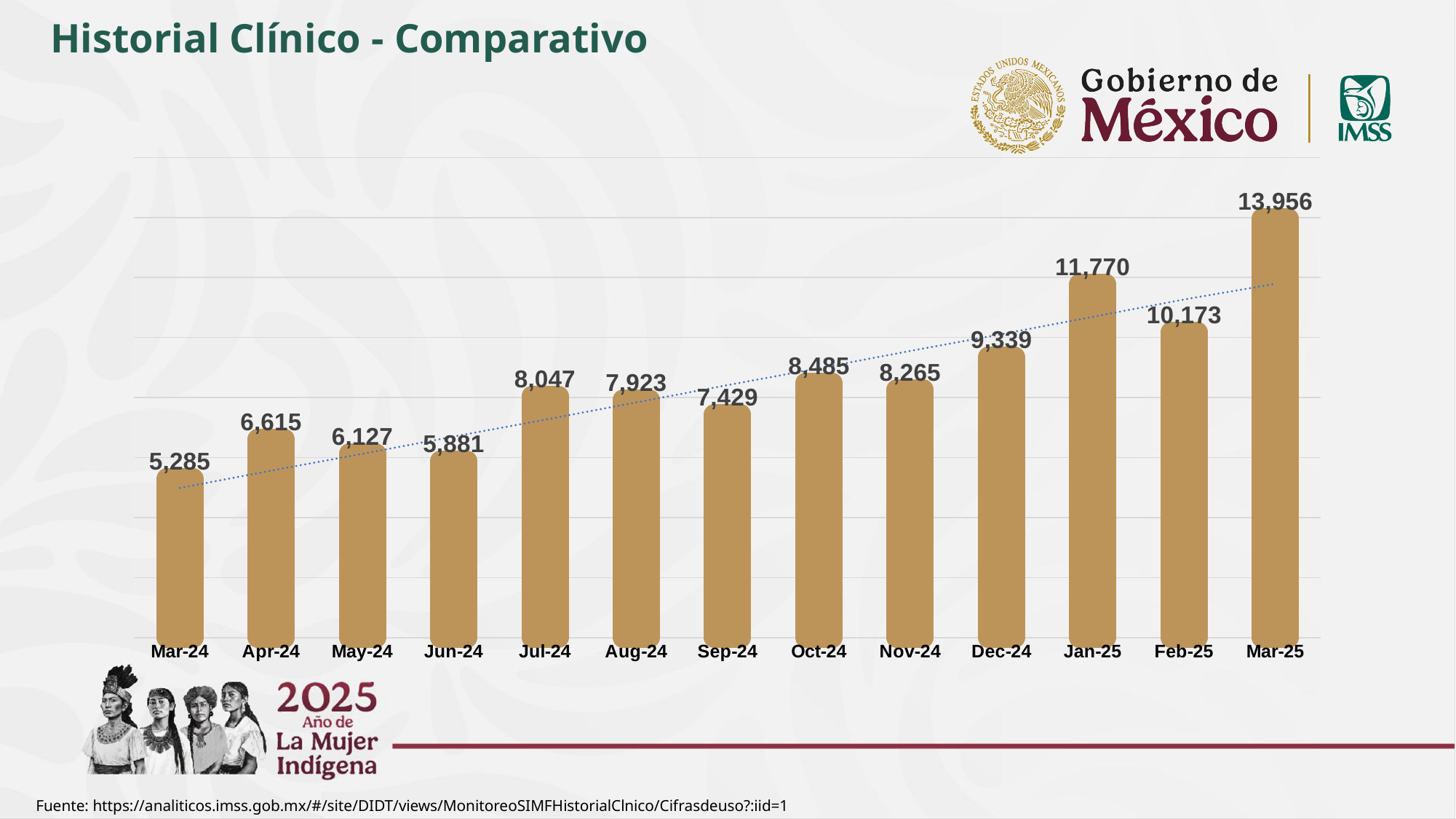
Which month has the lowest value? Mar-24 What kind of chart is shown on the slide? Bar chart Which month has the highest value? Mar-25 Which is larger, the value for Oct-24 or the value for Nov-24? Oct-24 How many months are shown on the x axis? 13 Which is larger, the value for Apr-24 or the value for Jun-24? Apr-24 Do the values generally rise or fall from Mar-24 to Mar-25? Rise What is the value for Dec-24? 9,339 What is the difference between the values for Jan-25 and Feb-25? 1,597 What is the difference between the values for Mar-25 and Mar-24? 8,671 What is the value for Jul-24? 8,047 What is the value for Mar-25? 13,956